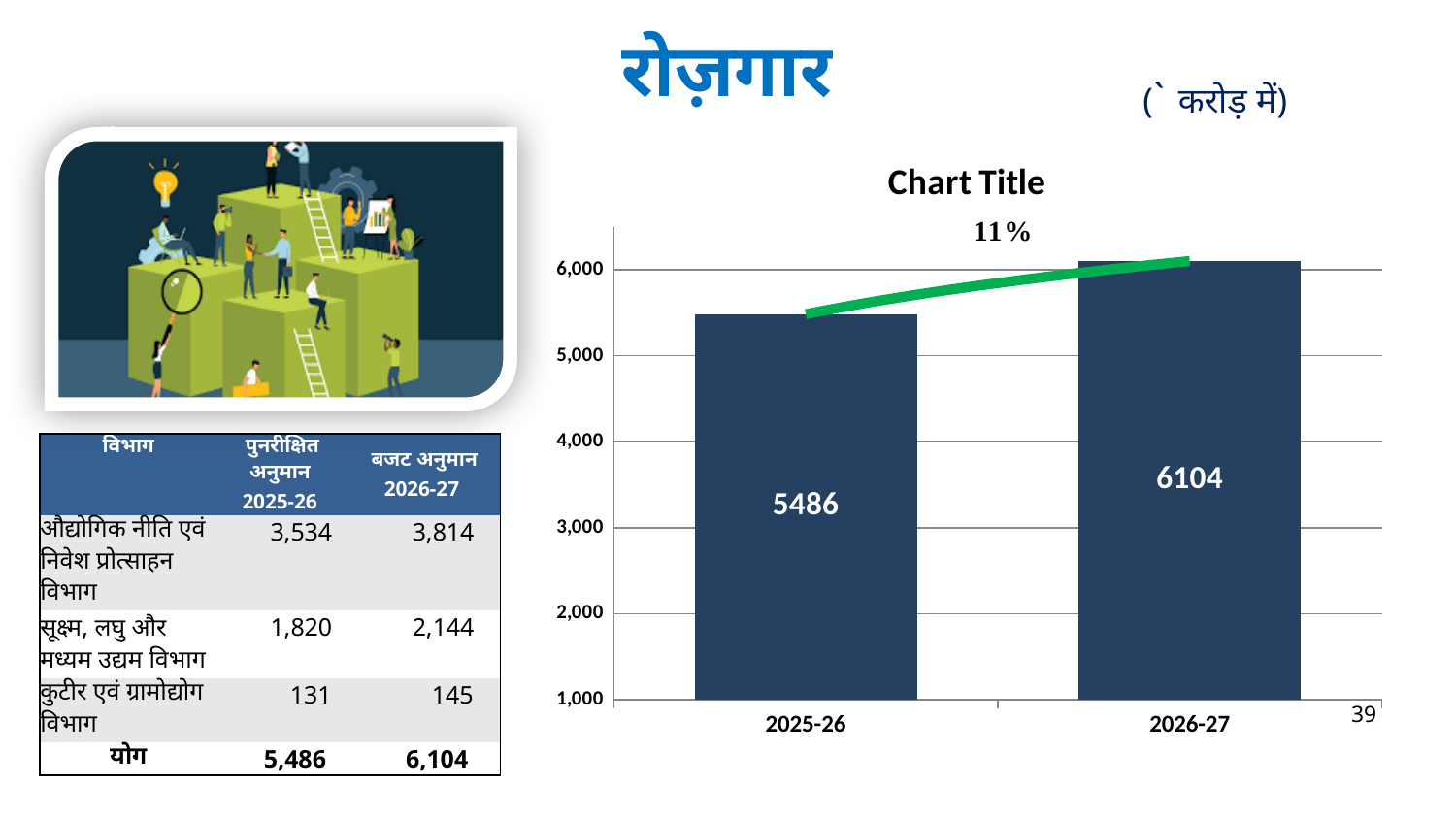
What type of chart is shown on the slide? bar chart What is the difference between the 2026-27 and 2025-26 values in the chart? 618 What is the value for 2025-26 in the chart? 5486 What is the value for 2026-27 in the chart? 6104 Is the value for 2026-27 greater or less than 6,000? greater How many bars are shown in the chart? 2 Is the value for 2025-26 larger or smaller than the value for 2026-27? smaller Do the values rise or fall from 2025-26 to 2026-27? rise What percentage change is annotated above the bars in the chart? 11% Which year has the lower value in the chart? 2025-26 Which year has the higher value in the chart? 2026-27 Is the value for 2025-26 greater or less than 5,000? greater